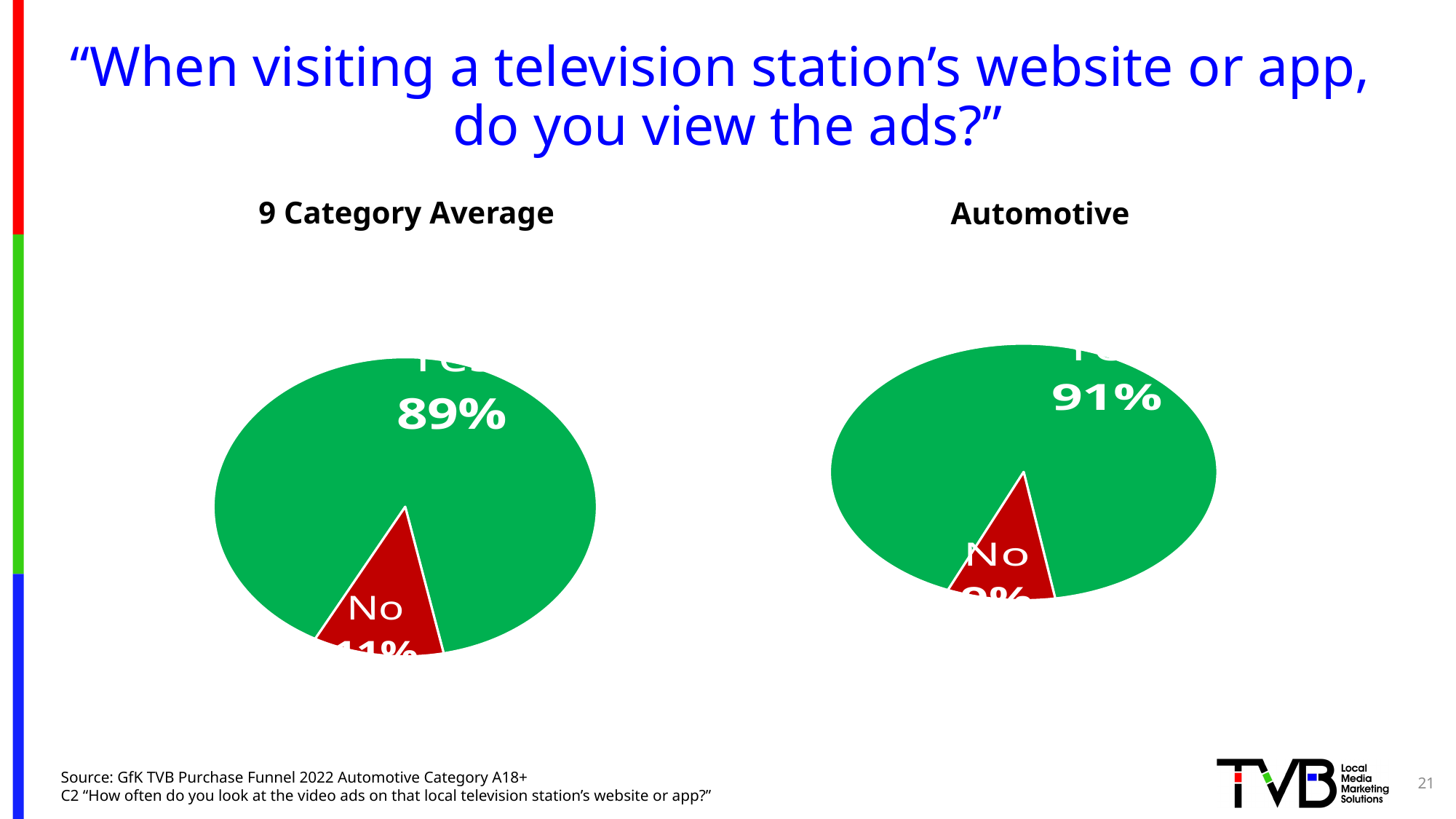
What colour is the Yes slice in the Automotive pie chart? Green In the 9 Category Average pie chart, which slice is the largest? Yes In the Automotive pie chart, what percentage answered Yes? 91% What kind of chart is used for the 9 Category Average? Pie chart In the 9 Category Average pie chart, which is larger, the Yes slice or the No slice? Yes Which chart shows a higher Yes percentage, 9 Category Average or Automotive? Automotive How many slices does the Automotive pie chart have? 2 What is the difference between the Yes percentage in the Automotive chart and the Yes percentage in the 9 Category Average chart? 2 percentage points In the Automotive pie chart, which slice is the smallest? No In the 9 Category Average pie chart, what share of the pie does the Yes slice represent? 89% What colour is the No slice in the 9 Category Average pie chart? Red In the 9 Category Average pie chart, what percentage answered Yes? 89%